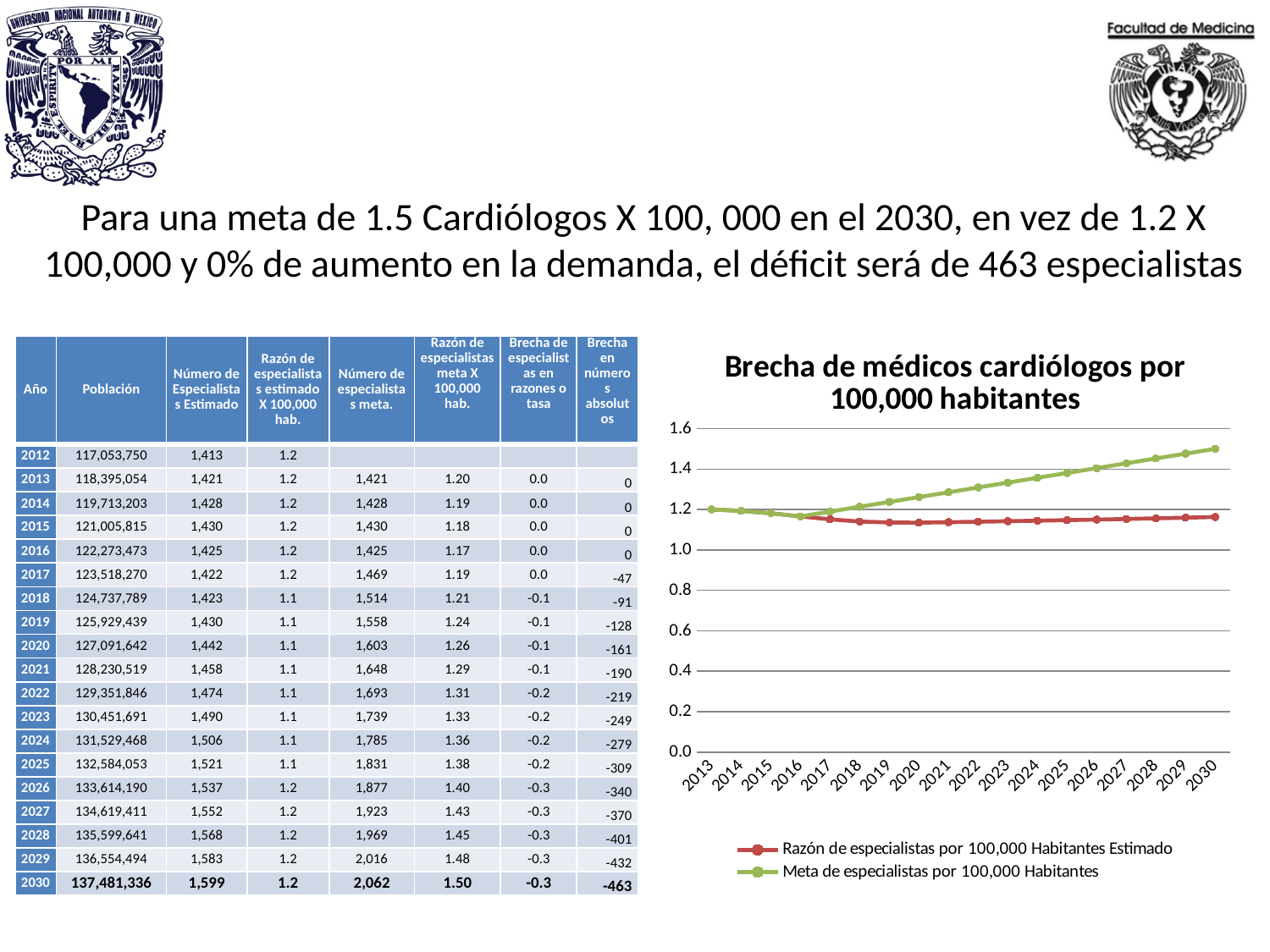
Which colour is used for the 'Meta de especialistas por 100,000 Habitantes' series? green In 2030, which series has the higher value: 'Meta de especialistas por 100,000 Habitantes' or 'Razón de especialistas por 100,000 Habitantes Estimado'? Meta de especialistas por 100,000 Habitantes Is the value of the 'Meta de especialistas por 100,000 Habitantes' series in 2030 greater or less than 1.4? greater How many years are plotted along the x axis of the chart? 18 What kind of chart is shown on the slide? line chart Is the value of the 'Meta de especialistas por 100,000 Habitantes' series in 2025 greater or less than 1.2? greater How many series does the legend of the chart list? 2 Is the value of the 'Razón de especialistas por 100,000 Habitantes Estimado' series in 2021 greater or less than 1.2? less In which year does the 'Meta de especialistas por 100,000 Habitantes' series reach its highest value? 2030 What is the title of the chart? Brecha de médicos cardiólogos por 100,000 habitantes Does the 'Meta de especialistas por 100,000 Habitantes' series rise or fall from 2017 to 2030? rise